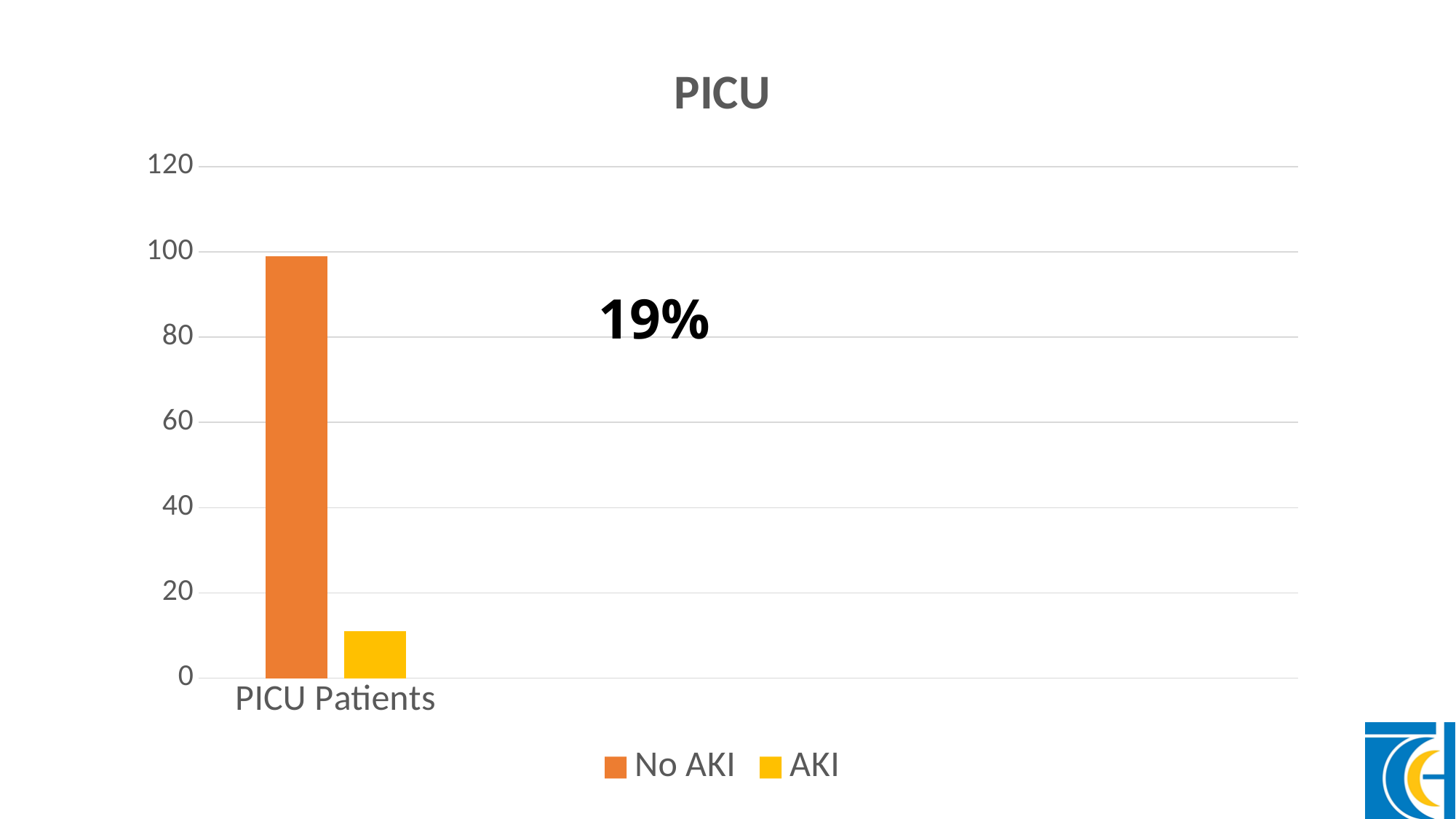
What is the highest value shown on the vertical axis? 120 Which series has the taller bar for PICU Patients, No AKI or AKI? No AKI What are the two series named in the legend? No AKI and AKI Is the value for AKI greater or less than 20? less Is the value for No AKI greater or less than 80? greater What kind of chart is shown on the slide? bar chart How many categories are shown on the x axis? 1 What is the title of the chart? PICU Which series has the highest bar in the chart? No AKI How many series does the legend list? 2 Which series has the lowest bar in the chart? AKI